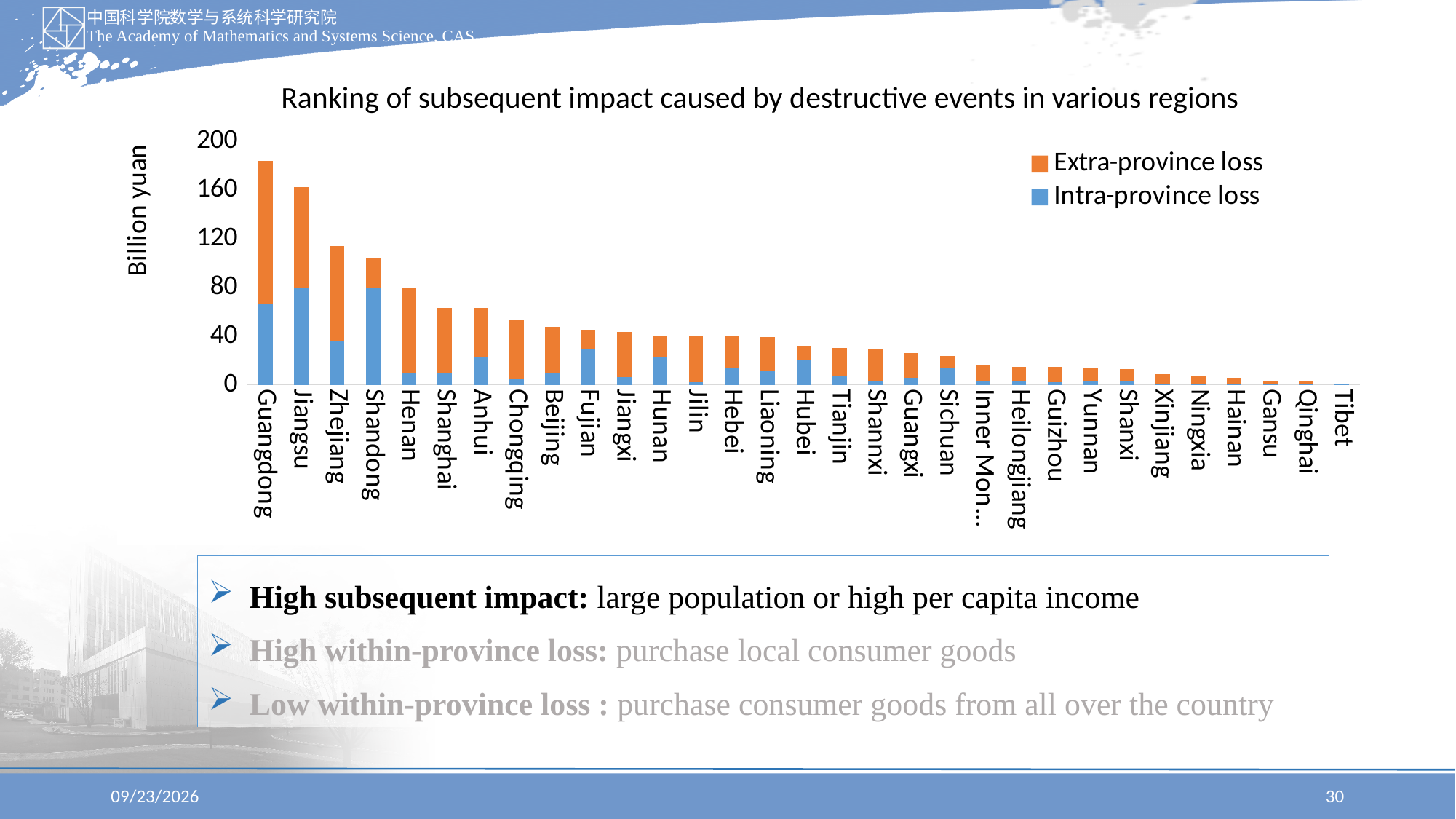
Which has a larger total subsequent impact, Henan or Shanghai? Henan Do the total bar values rise or fall moving from left to right along the x axis? Fall How many regions are shown along the x axis? 31 What kind of chart is shown on the slide? Stacked bar chart Is the total value for Zhejiang greater or less than 120? less How many series does the legend list? 2 Is the total value for Shandong greater or less than 80? greater Is the total value for Hubei greater or less than 40? less What is the label on the y axis? Billion yuan Which region has the lowest total subsequent impact? Tibet Which region has the highest total subsequent impact? Guangdong